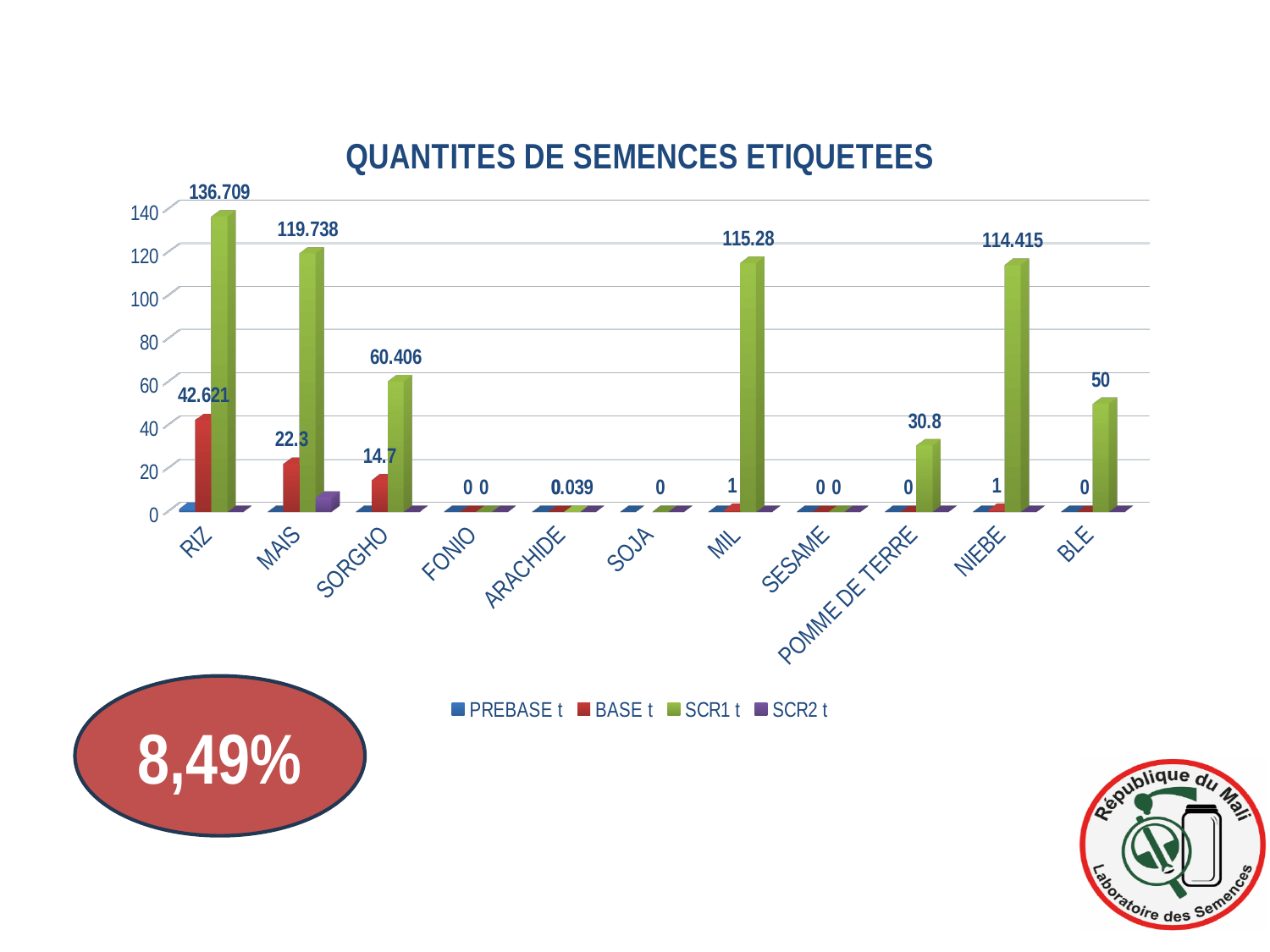
What is the difference between the SCR1 t values for RIZ and MAIS? 16.971 What is the SCR1 t value for MAIS? 119.738 How many series does the legend list? 4 Which has the larger SCR1 t value, MIL or NIEBE? MIL What is the SCR1 t value for RIZ? 136.709 What is the title of the chart? QUANTITES DE SEMENCES ETIQUETEES What is the BASE t value for SORGHO? 14.7 What is the BASE t value for RIZ? 42.621 How many categories are shown on the x axis? 11 Which category has the highest SCR1 t value? RIZ What kind of chart is shown on the slide? bar chart What is the SCR1 t value for BLE? 50